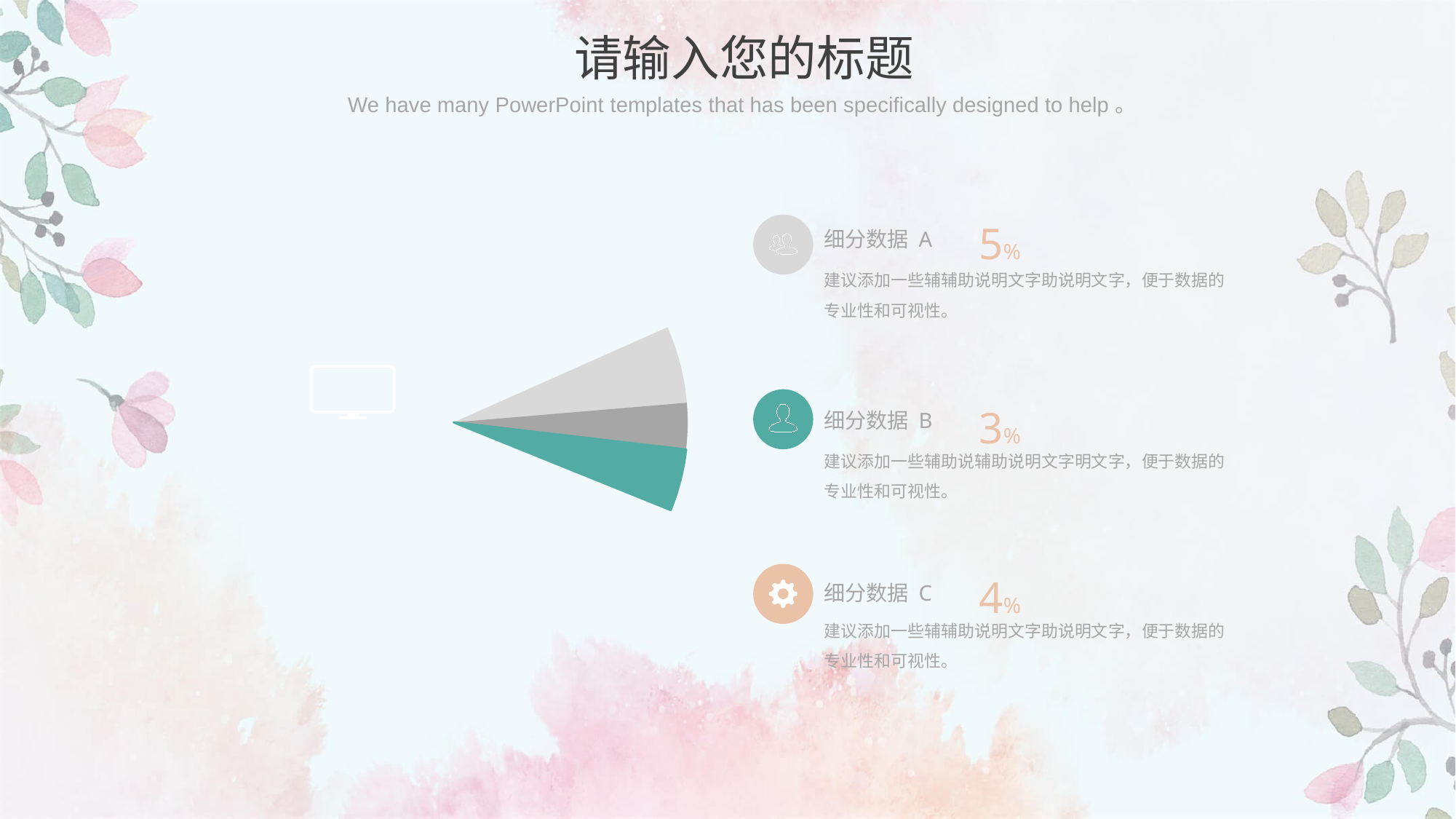
What colours are the three slices of the pie chart? light gray, dark gray and teal Which colour slice of the pie chart is the smallest? dark gray What kind of chart is shown on the slide? pie chart Which of the three listed items, 细分数据 A, B or C, has the highest percentage? 细分数据 A What percentage is shown next to 细分数据 A? 5% What percentage is shown next to 细分数据 C? 4% Is the light gray slice of the pie chart larger or smaller than the teal slice? larger Is the teal slice of the pie chart larger or smaller than the dark gray slice? larger What is the difference between the percentages shown for 细分数据 A and 细分数据 B? 2% What percentage is shown next to 细分数据 B? 3% Which colour slice of the pie chart is the largest? light gray